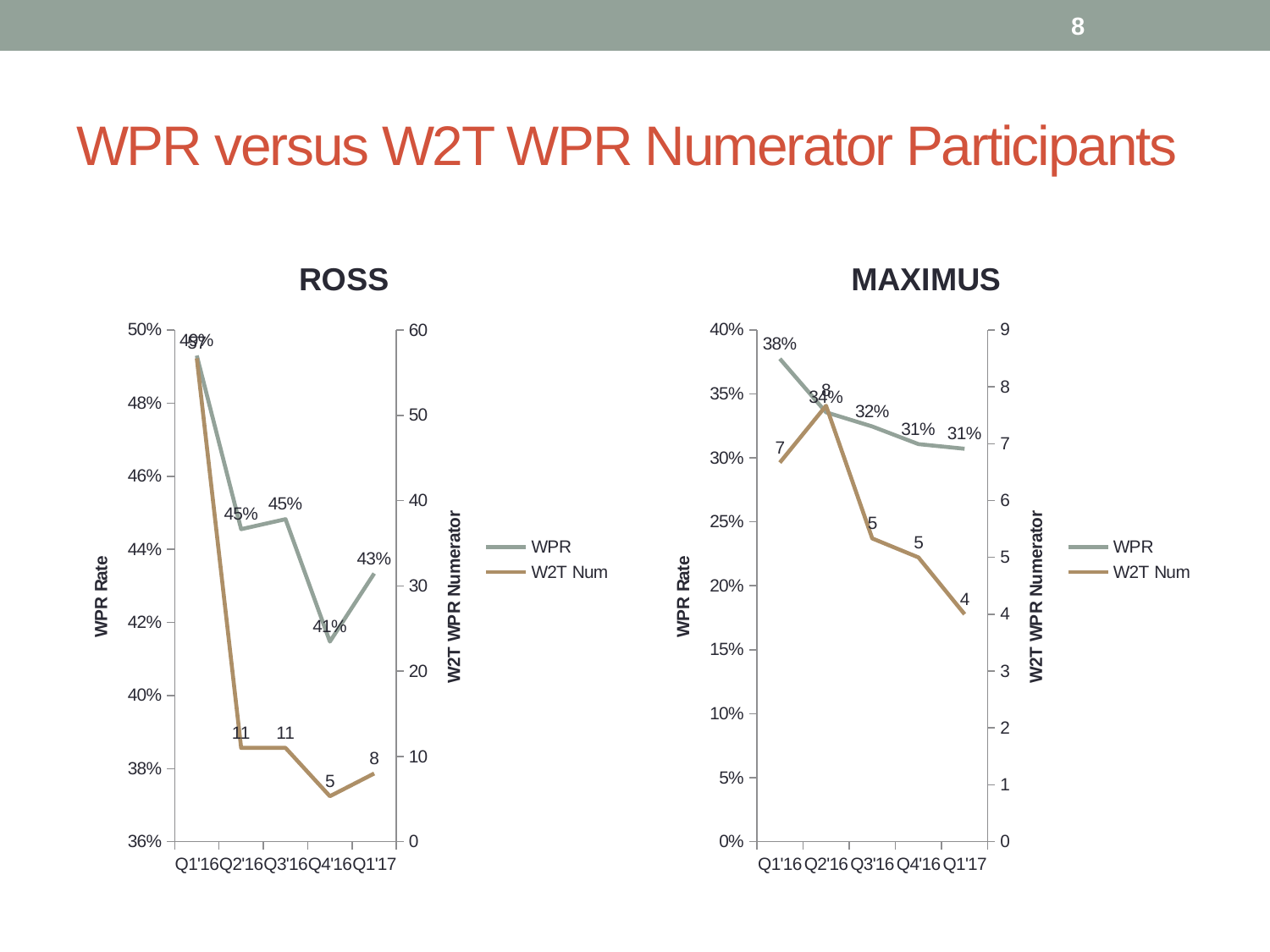
On the ROSS chart, what is the WPR value for Q4'16? 41% On the MAXIMUS chart, what is the WPR value for Q1'16? 38% On the MAXIMUS chart, what is the W2T Num value for Q1'17? 4 On the MAXIMUS chart, what is the difference between the WPR values for Q1'16 and Q3'16? 6 percentage points On the MAXIMUS chart, does the WPR series rise or fall from Q1'16 to Q1'17? Fall On the ROSS chart, what is the difference between the W2T Num values for Q3'16 and Q4'16? 6 What type of chart is the MAXIMUS chart? Line chart On the ROSS chart, which is larger, the WPR value for Q3'16 or for Q1'17? Q3'16 On the ROSS chart, what is the W2T Num value for Q1'17? 8 On the ROSS chart, which quarter has the lowest WPR value? Q4'16 On the MAXIMUS chart, which quarter has the highest W2T Num value? Q2'16 How many quarters are plotted on the x axis of the ROSS chart? 5